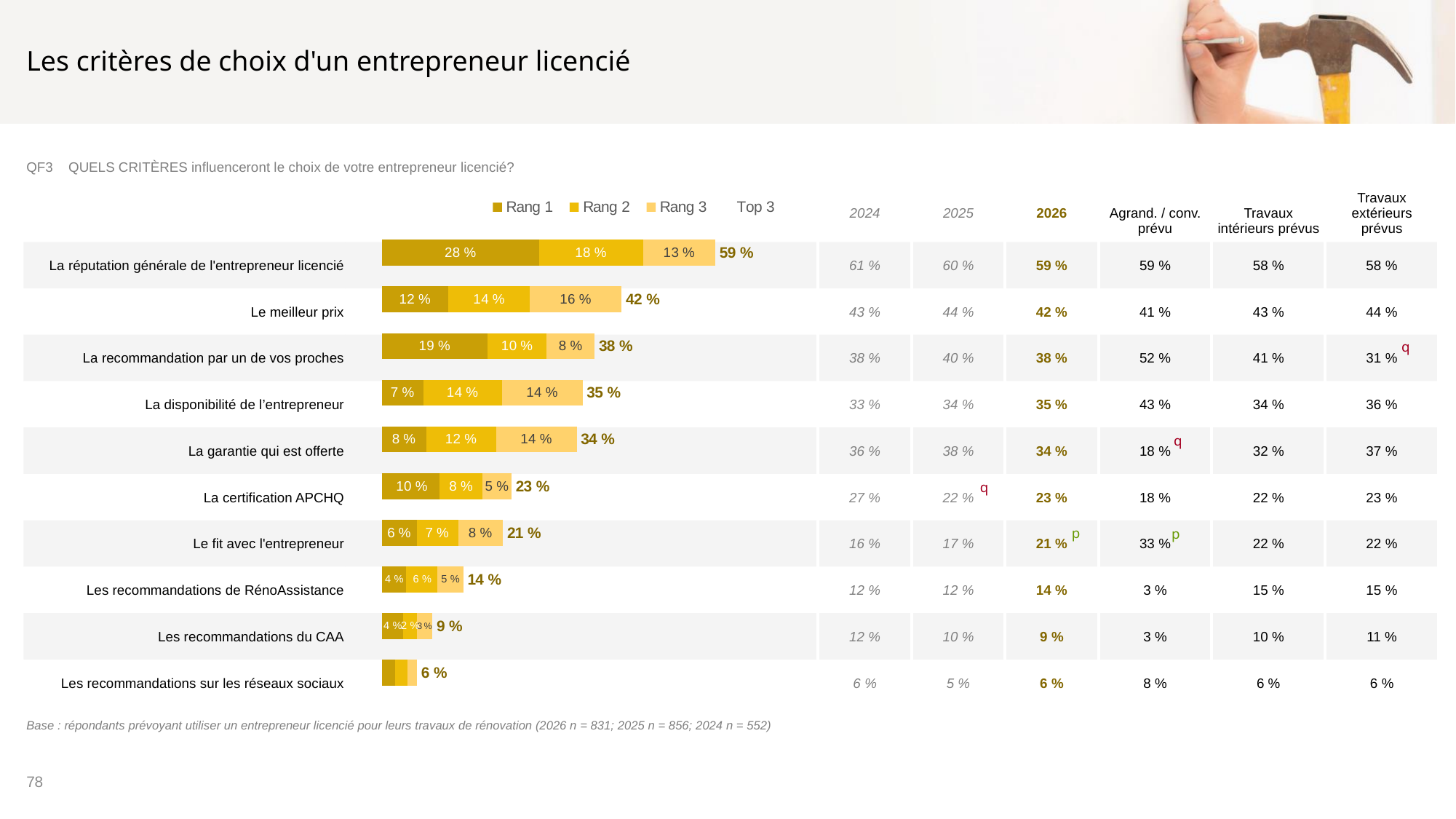
What is the Rang 2 value for 'La certification APCHQ'? 8 % What is the Rang 3 value for 'Le meilleur prix'? 16 % What is the Top 3 value for 'La disponibilité de l'entrepreneur'? 35 % What is the difference between the Top 3 values of 'La réputation générale de l'entrepreneur licencié' and 'Le meilleur prix'? 17 % Which has the larger Rang 1 value: 'La réputation générale de l'entrepreneur licencié' or 'La recommandation par un de vos proches'? La réputation générale de l'entrepreneur licencié How many 'Rang' series does the legend list? 3 How many criteria (categories) are plotted in the bar chart? 10 Which criterion has the highest Top 3 value? La réputation générale de l'entrepreneur licencié Which criterion has the lowest Top 3 value? Les recommandations sur les réseaux sociaux What kind of chart is used to show the ranking criteria? bar chart What is the total of the stacked bar for 'La garantie qui est offerte'? 34 % What is the Rang 1 value for 'La réputation générale de l'entrepreneur licencié'? 28 %